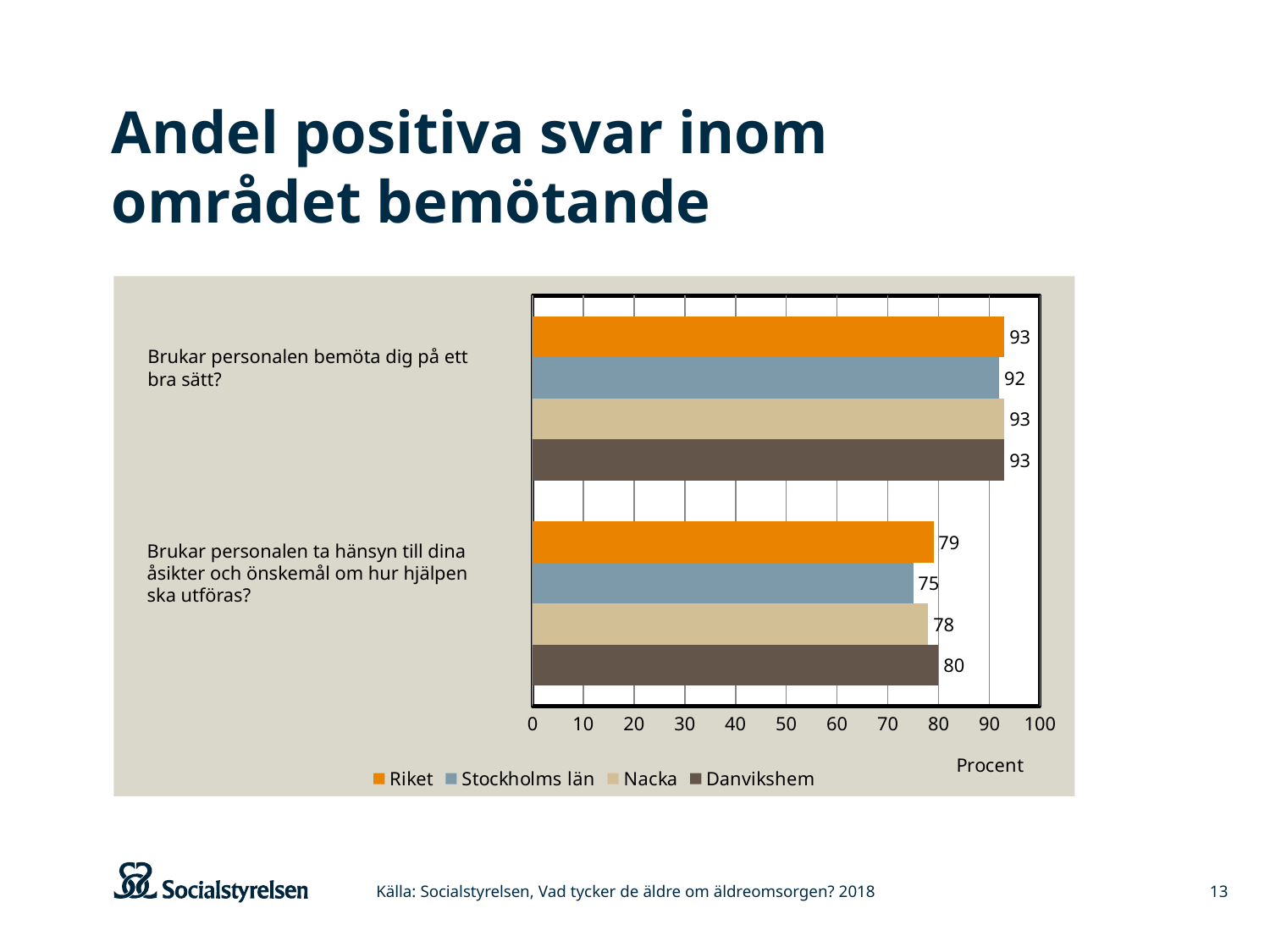
What is the value for Stockholms län on "Brukar personalen ta hänsyn till dina åsikter och önskemål om hur hjälpen ska utföras?"? 75 Which series has the highest value on "Brukar personalen ta hänsyn till dina åsikter och önskemål om hur hjälpen ska utföras?"? Danvikshem What kind of chart is shown on the slide? Bar chart What is the label of the x axis? Procent How many series does the legend list? 4 What is the value for Nacka on "Brukar personalen bemöta dig på ett bra sätt?"? 93 What is the value for Danvikshem on "Brukar personalen ta hänsyn till dina åsikter och önskemål om hur hjälpen ska utföras?"? 80 What is the value for Riket on "Brukar personalen bemöta dig på ett bra sätt?"? 93 What is the difference between the Danvikshem values for the two questions? 13 What is the difference between the Riket and Stockholms län values on "Brukar personalen ta hänsyn till dina åsikter och önskemål om hur hjälpen ska utföras?"? 4 Which series has the lowest value on "Brukar personalen ta hänsyn till dina åsikter och önskemål om hur hjälpen ska utföras?"? Stockholms län Which is larger: the Nacka value on "Brukar personalen bemöta dig på ett bra sätt?" or the Nacka value on "Brukar personalen ta hänsyn till dina åsikter och önskemål om hur hjälpen ska utföras?"? Brukar personalen bemöta dig på ett bra sätt?